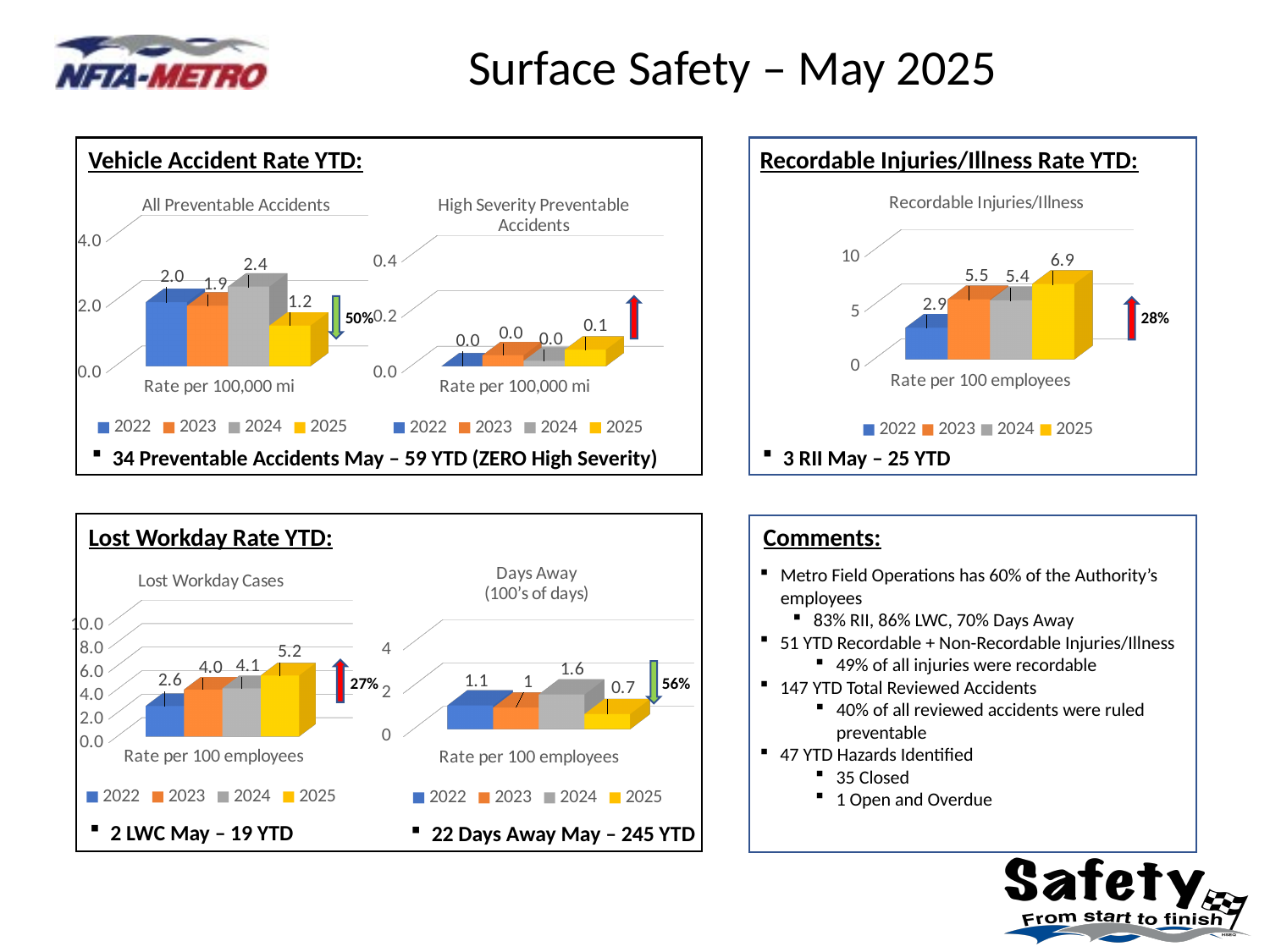
In the "All Preventable Accidents" chart, what is the value for 2025? 1.2 In the "Recordable Injuries/Illness" chart, what is the value for 2022? 2.9 In the "Lost Workday Cases" chart, which is larger, the value for 2022 or the value for 2023? 2023 In the "Recordable Injuries/Illness" chart, which year has the lowest value? 2022 In the "Days Away (100's of days)" chart, how many series does the legend list? 4 In the "Recordable Injuries/Illness" chart, is the value for 2025 greater or less than 5? greater In the "High Severity Preventable Accidents" chart, what is the value for 2025? 0.1 In the "Lost Workday Cases" chart, what is the value for 2025? 5.2 In the "All Preventable Accidents" chart, which year has the highest value? 2024 In the "All Preventable Accidents" chart, what is the difference between the 2024 and 2025 values? 1.2 In the "Days Away (100's of days)" chart, what is the value for 2024? 1.6 What kind of chart is the "Lost Workday Cases" chart? Bar chart